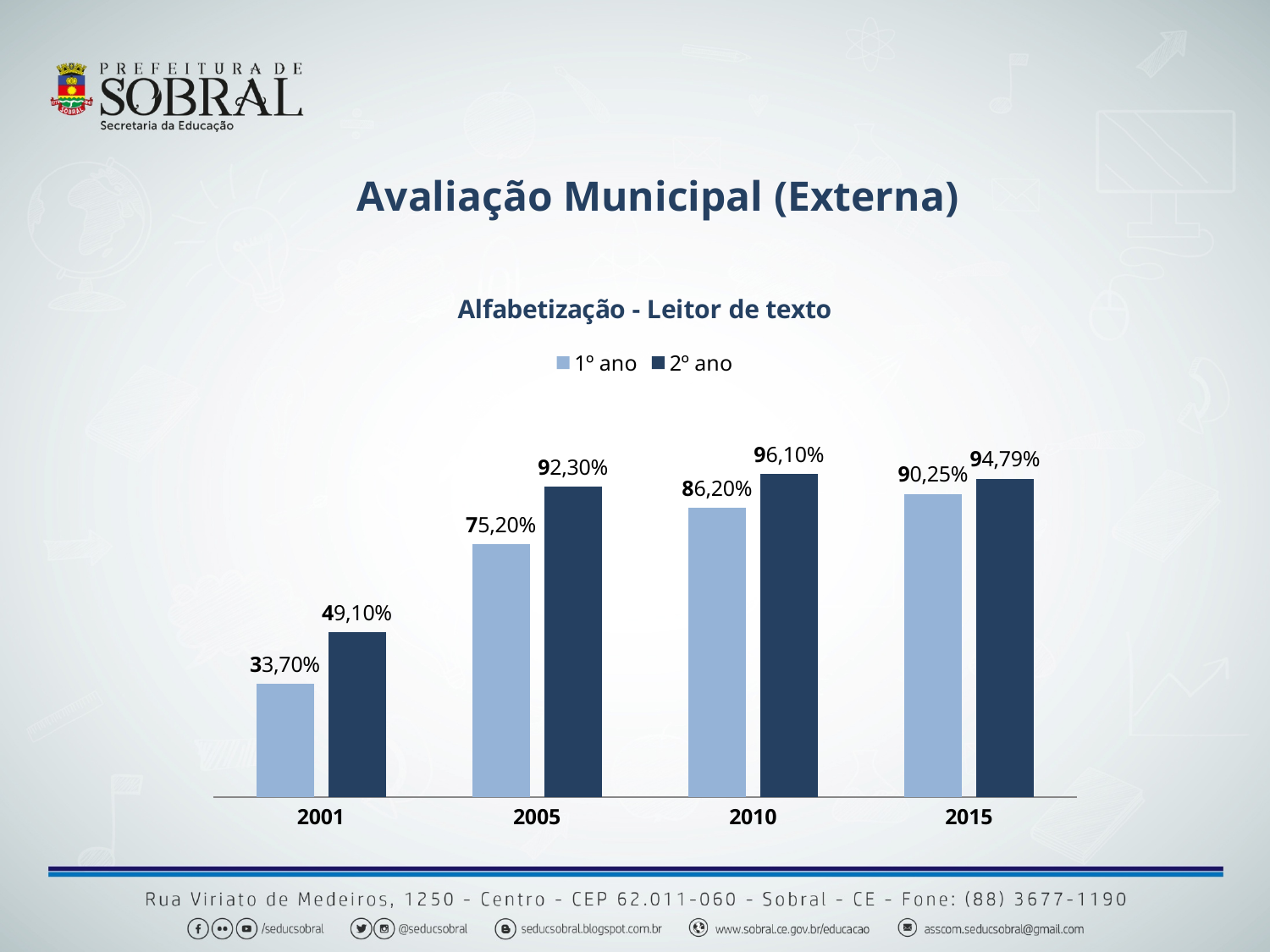
Which is larger in 2015: the 1º ano value or the 2º ano value? 2º ano In which year is the 1º ano value lowest? 2001 What is the value for 1º ano in 2015? 90,25% Does the 1º ano value rise or fall from 2001 to 2015? Rise How many years are shown on the x axis? 4 What is the value for 2º ano in 2005? 92,30% What is the value for 2º ano in 2010? 96,10% How many series does the legend list? 2 What is the difference between the 2º ano and 1º ano values in 2001? 15,40 percentage points In which year is the 2º ano value highest? 2010 What is the value for 1º ano in 2001? 33,70% What kind of chart is shown? Bar chart